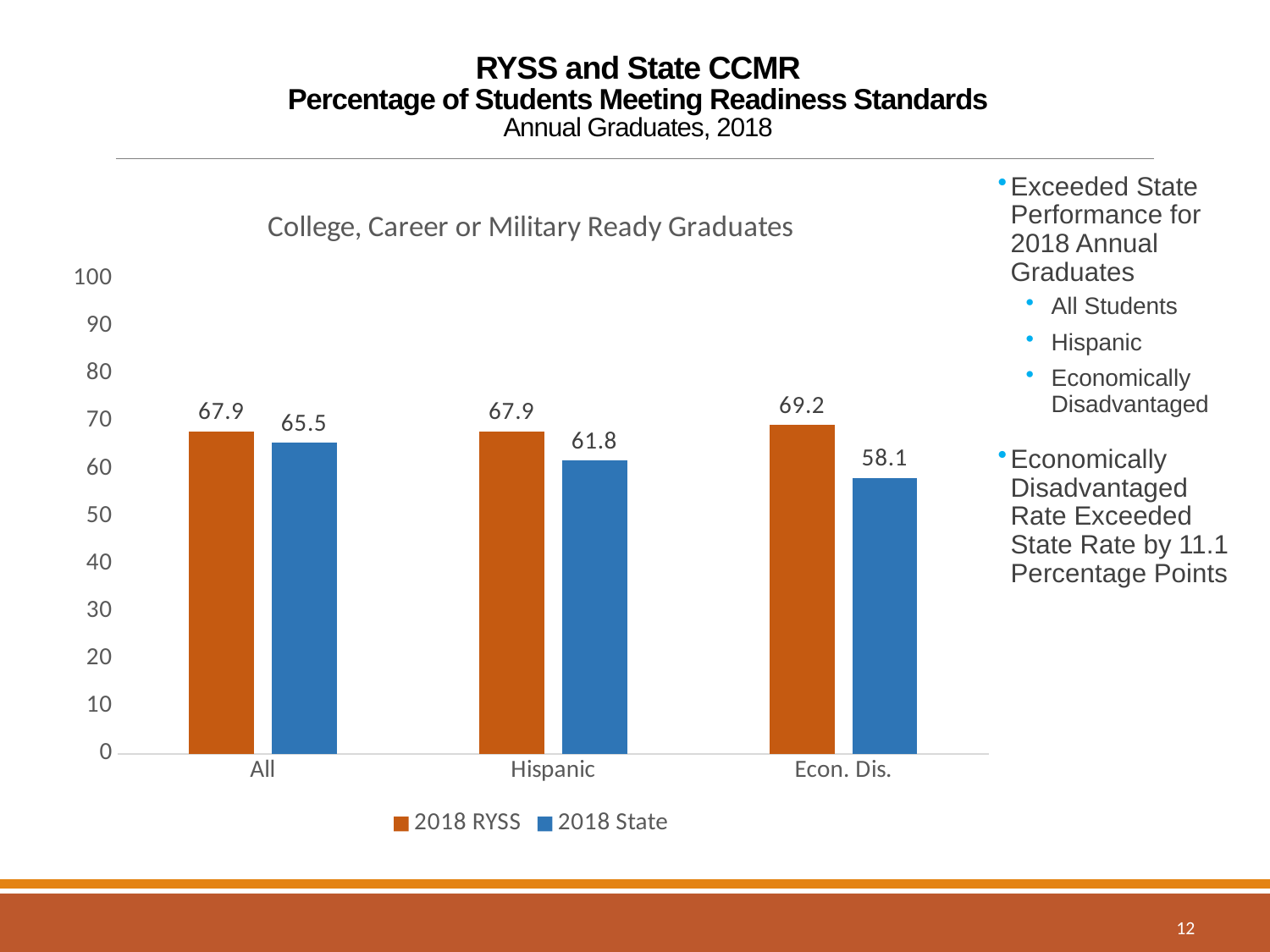
Which category has the highest 2018 RYSS value? Econ. Dis. What is the 2018 RYSS value for Hispanic? 67.9 What is the 2018 State value for Econ. Dis.? 58.1 How many categories are shown on the x axis? 3 What is the difference between the 2018 RYSS and 2018 State values for Econ. Dis.? 11.1 How many series does the legend list? 2 Which category has the lowest 2018 State value? Econ. Dis. What kind of chart is shown on the slide? bar chart Which is larger for All: the 2018 RYSS value or the 2018 State value? 2018 RYSS Is the 2018 State value for Econ. Dis. greater or less than 60? less What is the 2018 State value for All? 65.5 What is the difference between the 2018 RYSS and 2018 State values for Hispanic? 6.1